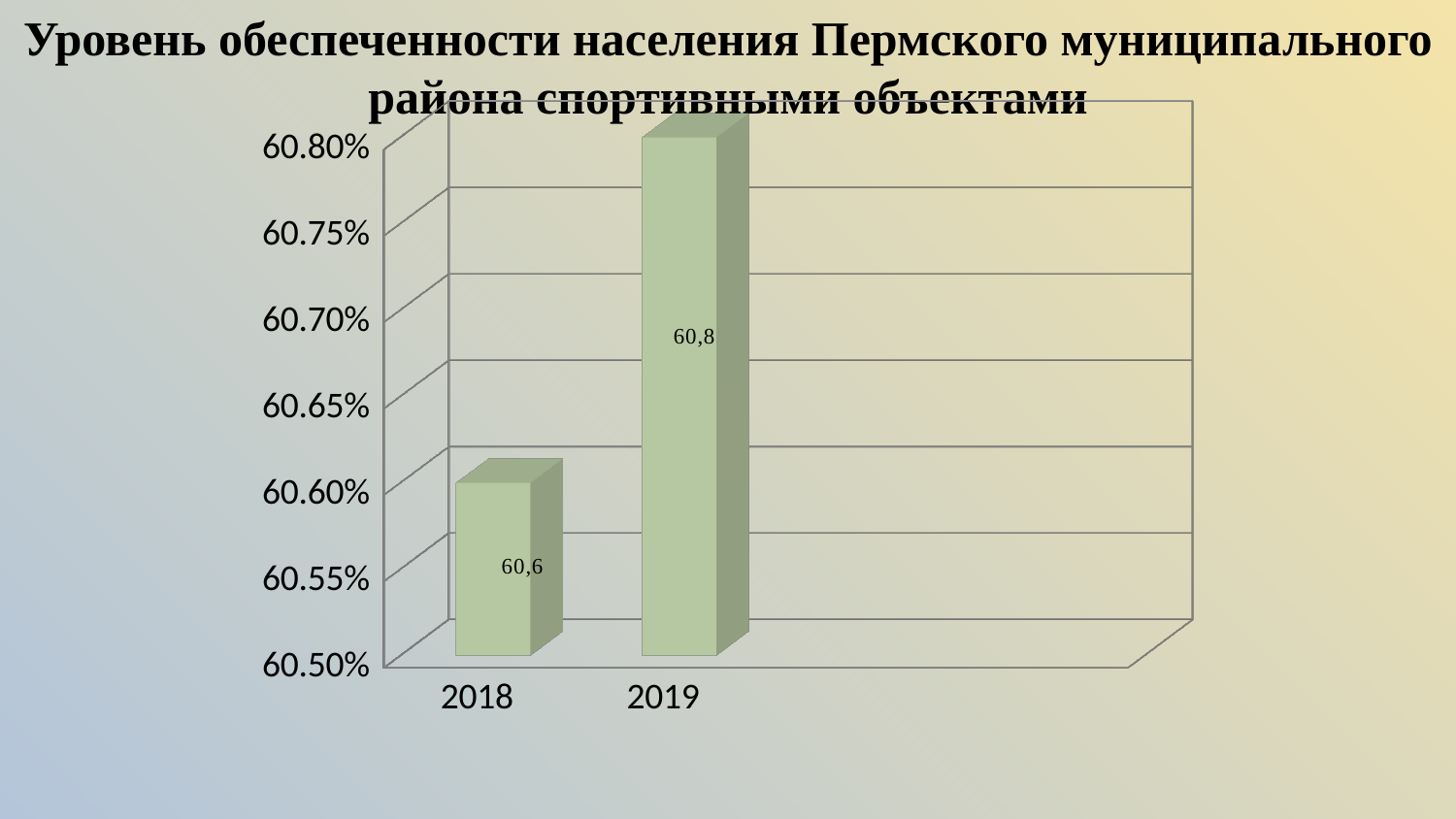
Is the value for 2019 greater or less than 60.75%? greater What is the title of the chart? Уровень обеспеченности населения Пермского муниципального района спортивными объектами Is the value for 2018 greater or less than 60.65%? less What is the value for 2019? 60,8 Do the values rise or fall from 2018 to 2019? rise How many years are shown on the chart? 2 What is the value for 2018? 60,6 Which year has the lowest value? 2018 Which is larger, the value for 2018 or the value for 2019? 2019 Which year has the highest value? 2019 What is the difference between the values for 2019 and 2018? 0,2 What kind of chart is shown on the slide? bar chart